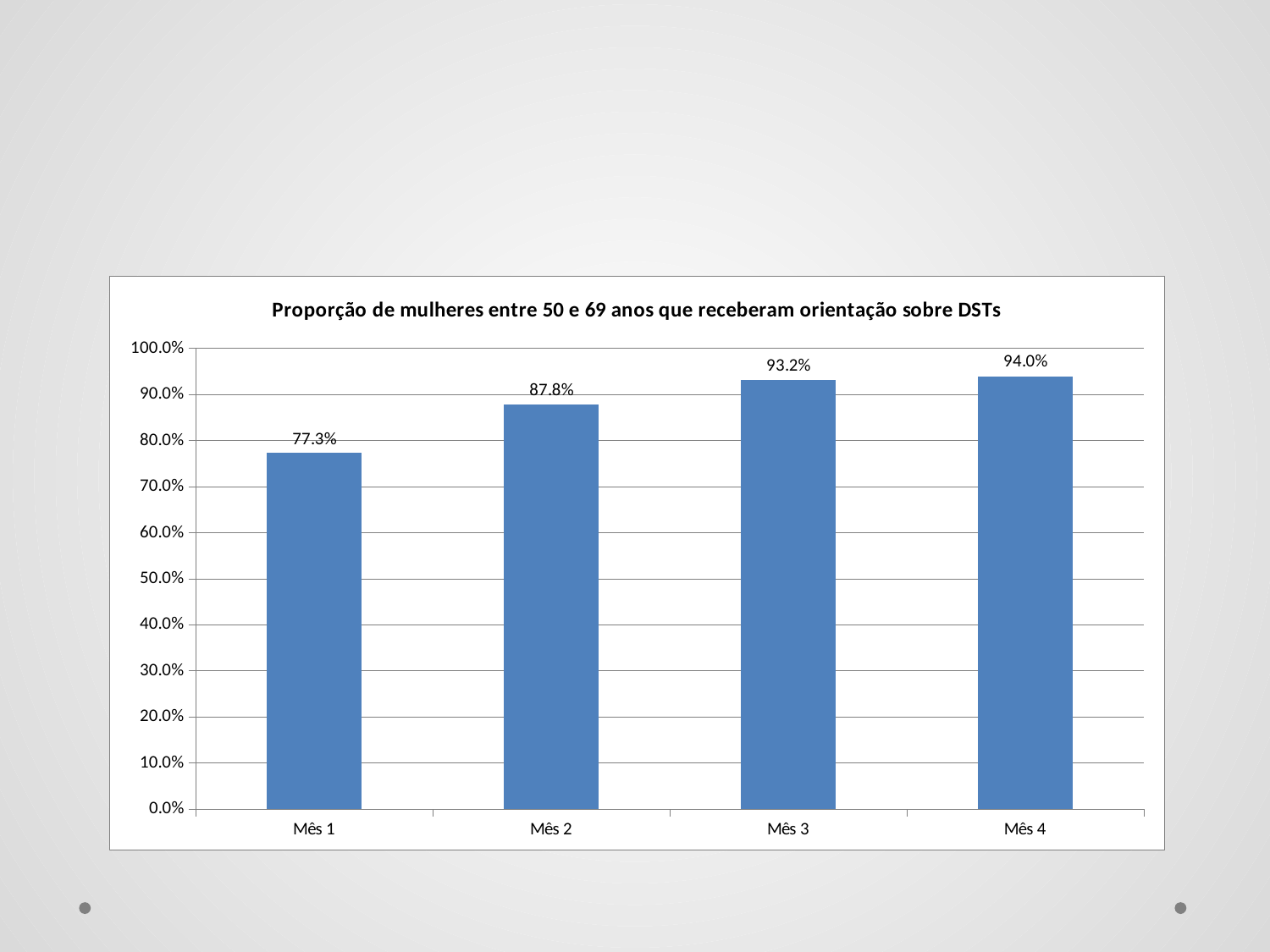
What is the value for Mês 3? 93.2% Which month has the highest value? Mês 4 Which is larger, the value for Mês 2 or the value for Mês 3? Mês 3 Do the values rise or fall from Mês 1 to Mês 4? rise How many months are shown on the x axis? 4 What is the value for Mês 4? 94.0% What kind of chart is shown on the slide? bar chart Which month has the lowest value? Mês 1 What is the value for Mês 1? 77.3% What is the value for Mês 2? 87.8% What is the difference between the values for Mês 2 and Mês 1? 10.5% Is the value for Mês 1 greater or less than 80.0%? less